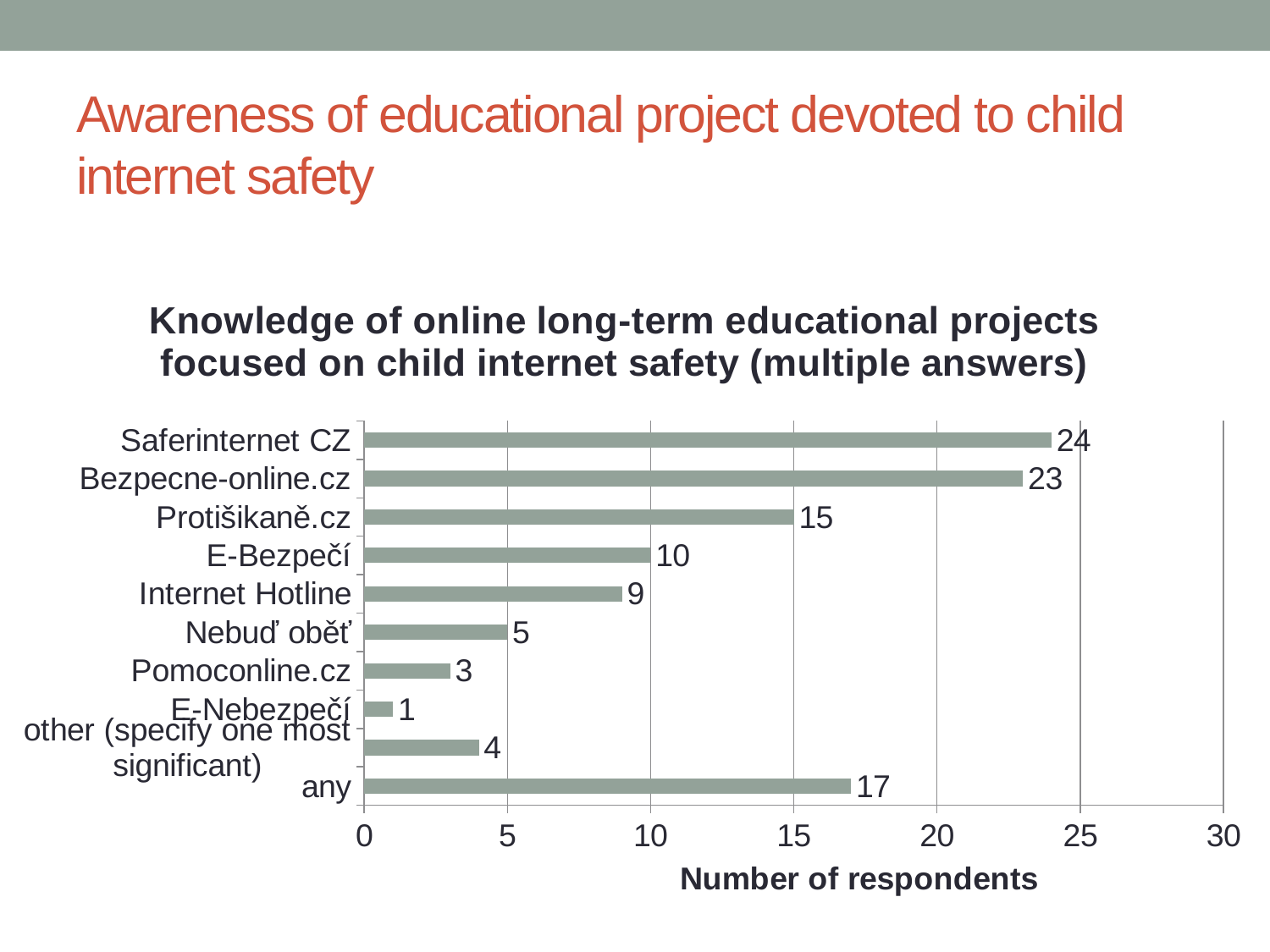
Is the value for Pomoconline.cz greater or less than 5? less What is the number of respondents for Internet Hotline? 9 What is the label of the horizontal axis? Number of respondents What kind of chart is shown on the slide? bar chart Which project has the highest number of respondents? Saferinternet CZ What is the difference in respondents between Bezpecne-online.cz and Protišikaně.cz? 8 How many respondents knew Saferinternet CZ? 24 What is the difference between the values for Saferinternet CZ and E-Nebezpečí? 23 What is the value for the 'any' category? 17 How many categories are shown on the chart? 10 Which has more respondents, E-Bezpečí or Nebuď oběť? E-Bezpečí Which category has the lowest number of respondents? E-Nebezpečí